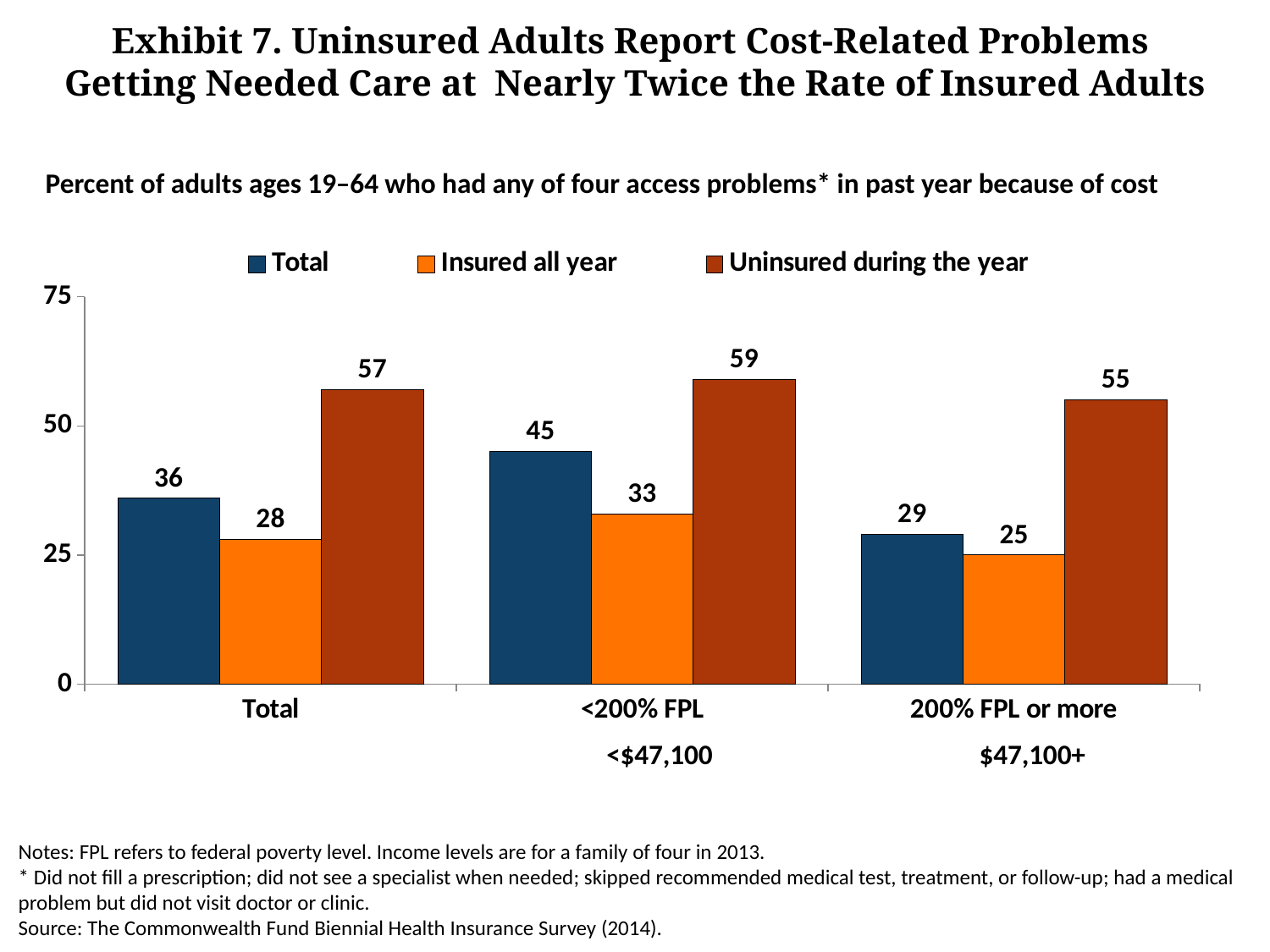
Is the value for Uninsured during the year in the <200% FPL category greater or less than 50? greater How many series does the legend list? 3 What is the value for Uninsured during the year in the Total category? 57 Which series is shown in orange in the legend? Insured all year How many categories are shown on the x axis? 3 What kind of chart is shown on the slide? bar chart Which is larger in the 200% FPL or more category: Total or Insured all year? Total What is the value for Total in the 200% FPL or more category? 29 What is the value for Insured all year in the <200% FPL category? 33 What is the difference between Uninsured during the year and Insured all year in the Total category? 29 Which category has the lowest value for Insured all year? 200% FPL or more Which category has the highest value for Uninsured during the year? <200% FPL